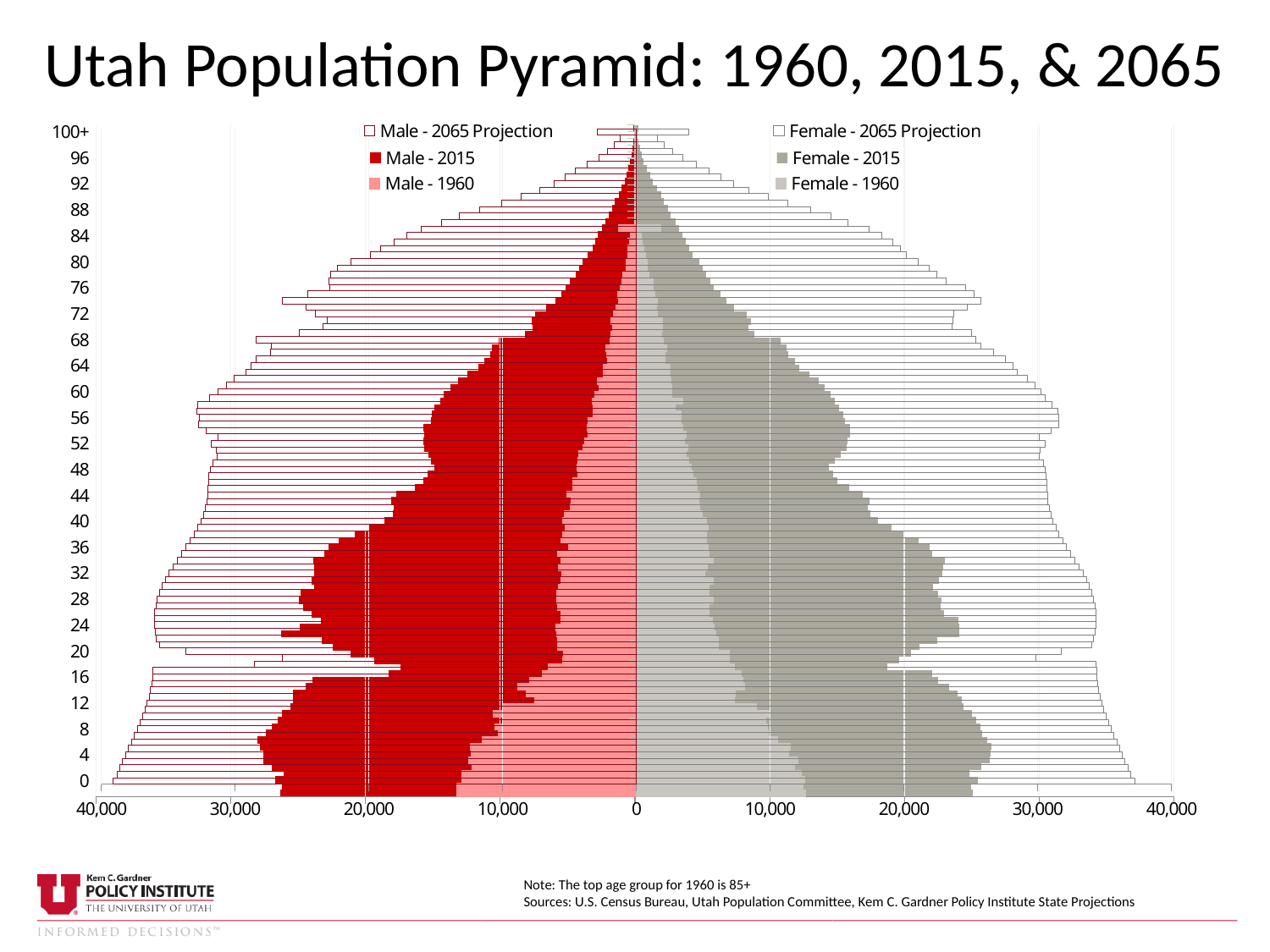
At age 0, which is larger: Male - 2015 or Male - 1960? Male - 2015 How many series does the legend list? 6 Which series is drawn in solid red? Male - 2015 Is the value for Male - 1960 at age 0 greater or less than 20,000? less Is the value for Male - 1960 at age 60 greater or less than 10,000? less At age 80, which is larger: Female - 2065 Projection or Female - 1960? Female - 2065 Projection Do the Male - 1960 values generally rise or fall as age increases from 0 to 100+? fall What kind of chart is shown on the slide? bar chart Is the value for Female - 2065 Projection at age 0 greater or less than 30,000? greater What is the title of the chart? Utah Population Pyramid: 1960, 2015, & 2065